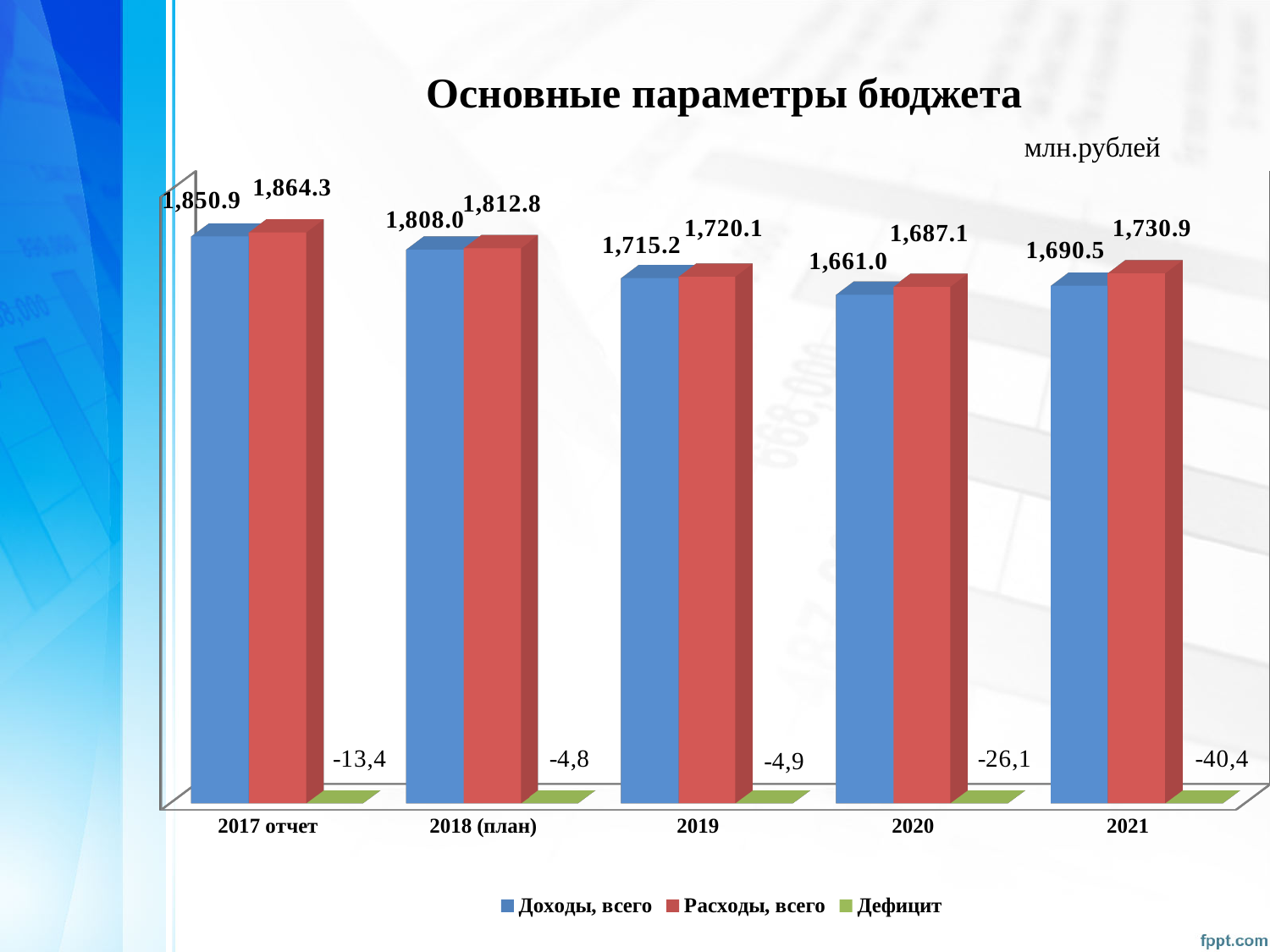
What is the value of Расходы, всего for 2021? 1,730.9 What is the difference between Расходы, всего and Доходы, всего in 2021? 40.4 What is the Дефицит value shown for 2020? -26,1 What unit of measurement is indicated on the chart? млн.рублей What kind of chart is shown on the slide? Bar chart Which year has the highest value of Расходы, всего? 2017 отчет Which is larger in 2018 (план): Доходы, всего or Расходы, всего? Расходы, всего What is the value of Доходы, всего for 2017 отчет? 1,850.9 What is the value of Расходы, всего for 2019? 1,720.1 Which year has the lowest value of Доходы, всего? 2020 How many years (categories) are shown on the x axis? 5 How many series does the legend list? 3